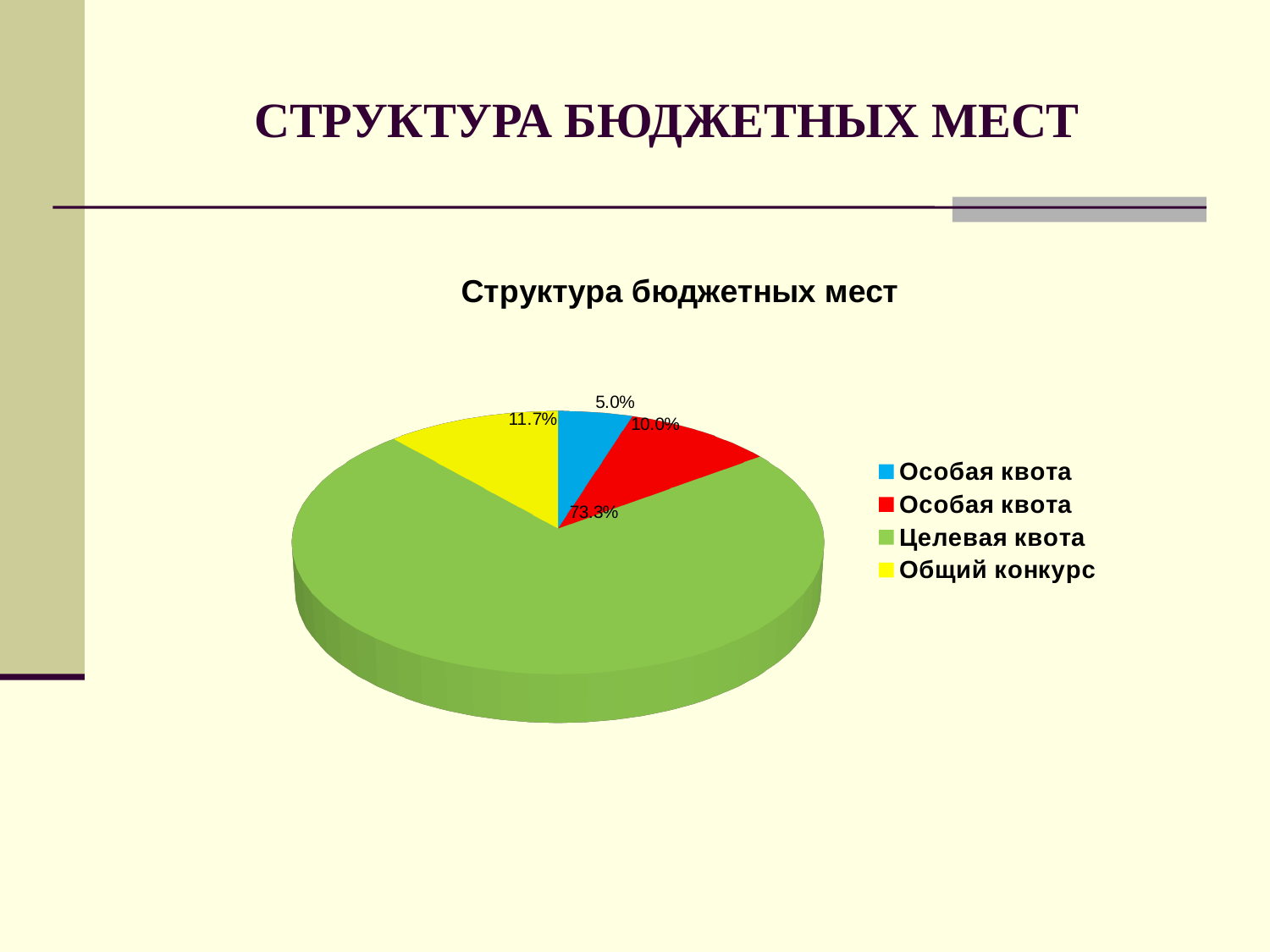
What share of the pie does Общий конкурс have? 11.7% What share of the pie does the blue Особая квота slice have? 5.0% Which slice of the pie is the smallest? the blue Особая квота slice (5.0%) What is the title of the chart? Структура бюджетных мест What is the difference between the share for Целевая квота and the share for Общий конкурс? 61.6% Which is larger: the share for Общий конкурс or the share for the red Особая квота slice? Общий конкурс What share of the pie does Целевая квота have? 73.3% Which category has the largest slice of the pie? Целевая квота How many slices does the pie chart have? 4 What kind of chart is shown on the slide? pie chart How many entries does the legend list? 4